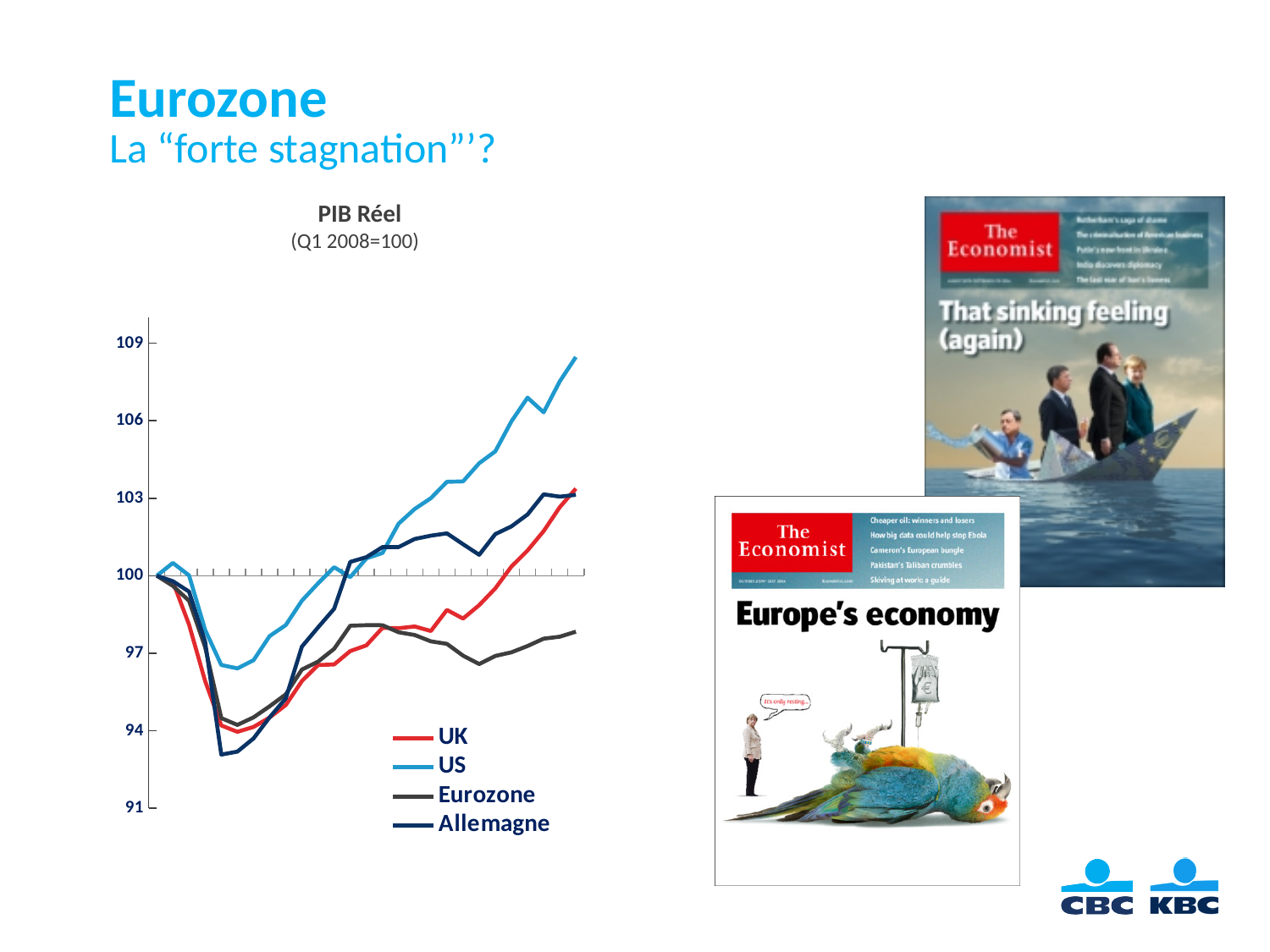
What kind of chart is shown on the slide? line chart Which series are listed in the legend of the PIB Réel chart? UK, US, Eurozone, Allemagne Which series is highest at the right end of the PIB Réel chart? US What base period is indicated under the chart title PIB Réel? Q1 2008=100 Which series is lowest at the right end of the PIB Réel chart? Eurozone Is the final value of the Eurozone series greater or less than 100? less How many series does the legend of the PIB Réel chart list? 4 At the right end of the PIB Réel chart, which is higher: UK or Eurozone? UK Does the US series end higher or lower than where it starts in the PIB Réel chart? higher Which series reaches the lowest point during the downturn in the PIB Réel chart? Allemagne Is the lowest point of the Allemagne series greater or less than 94? less Is the final value of the US series greater or less than 106? greater